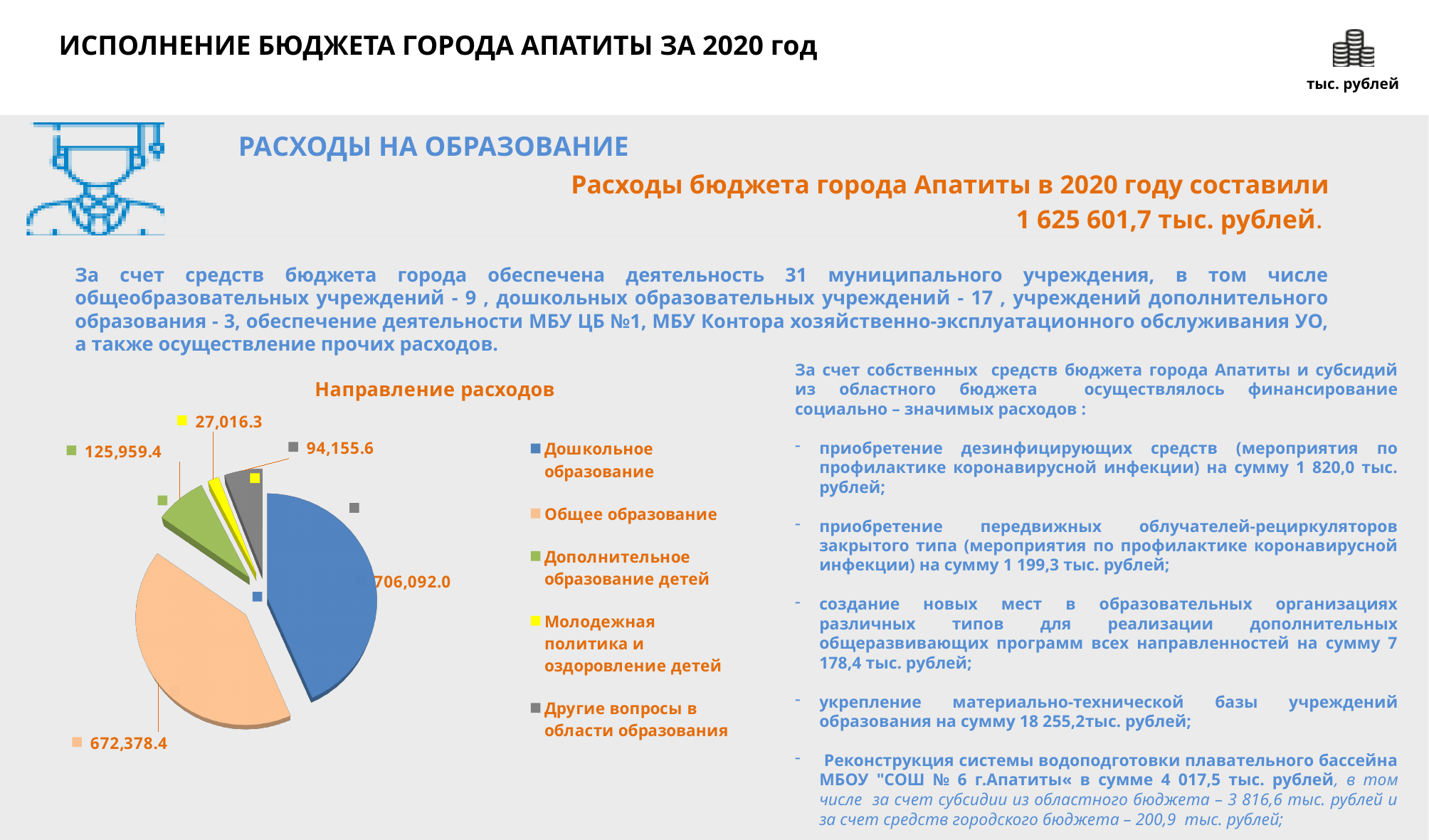
Which category has the smallest slice in the pie chart? Молодежная политика и оздоровление детей What colour is the slice for "Молодежная политика и оздоровление детей" in the pie chart? yellow What is the difference between the values for "Дошкольное образование" and "Общее образование"? 33,713.6 What is the value for "Общее образование" in the pie chart? 672,378.4 Which is larger: "Дополнительное образование детей" or "Другие вопросы в области образования"? Дополнительное образование детей Which category has the largest slice in the pie chart? Дошкольное образование What is the value for "Молодежная политика и оздоровление детей" in the pie chart? 27,016.3 What is the value for "Дошкольное образование" in the pie chart? 706,092.0 What type of chart is shown under the title "Направление расходов"? pie chart What is the value for "Другие вопросы в области образования" in the pie chart? 94,155.6 How many categories does the pie chart legend list? 5 What is the value for "Дополнительное образование детей" in the pie chart? 125,959.4